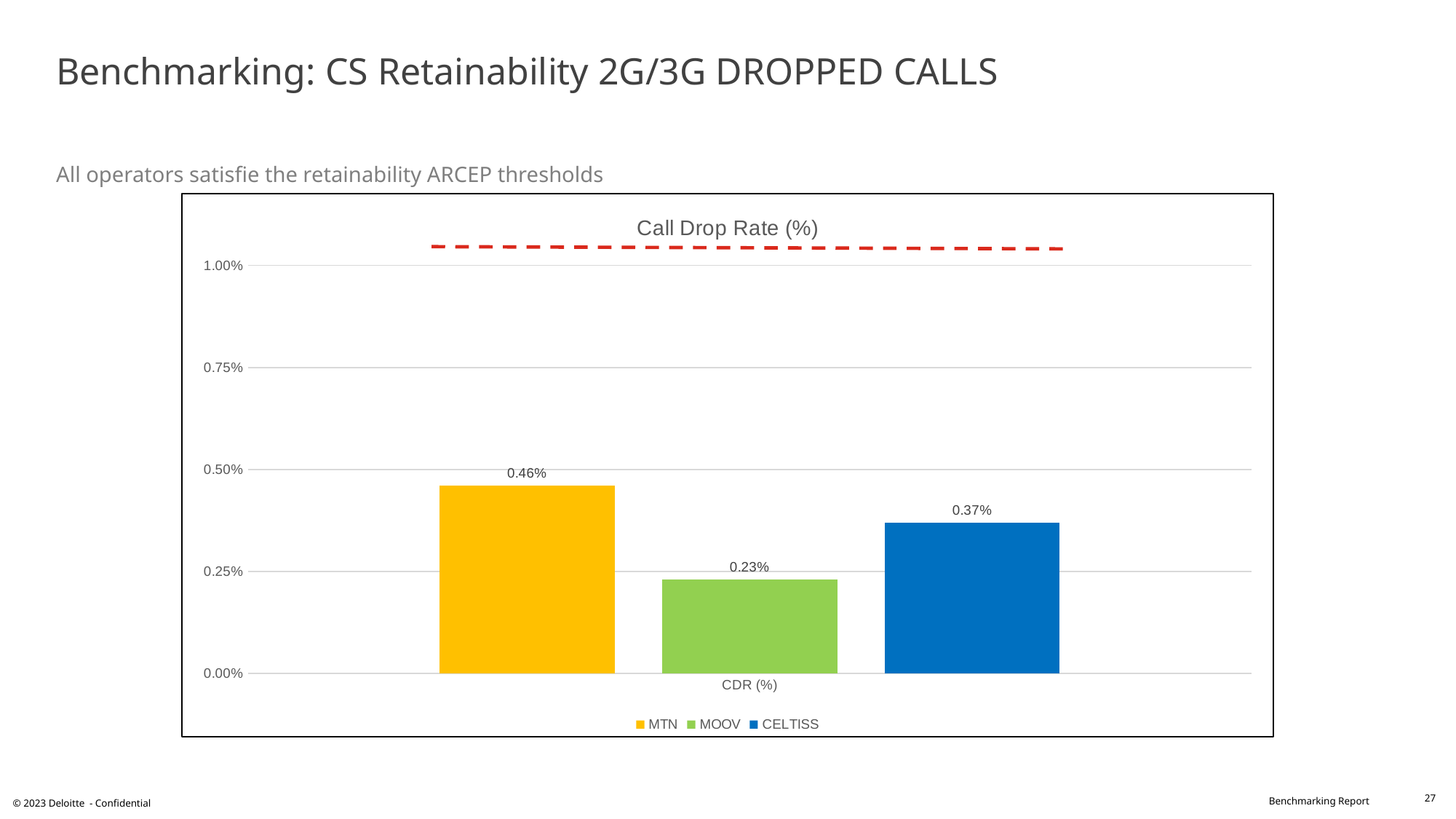
Which has a higher Call Drop Rate, CELTISS or MOOV? CELTISS Which operator has the highest Call Drop Rate? MTN How many series does the legend list? 3 What is the Call Drop Rate for MTN? 0.46% What is the Call Drop Rate for CELTISS? 0.37% What is the title of the chart? Call Drop Rate (%) What is the Call Drop Rate for MOOV? 0.23% Which operator has the lowest Call Drop Rate? MOOV What is the difference between the Call Drop Rate of MTN and MOOV? 0.23% What is the difference between the Call Drop Rate of MTN and CELTISS? 0.09% What kind of chart is shown on the slide? Bar chart Is the Call Drop Rate for MTN greater or less than 0.50%? less